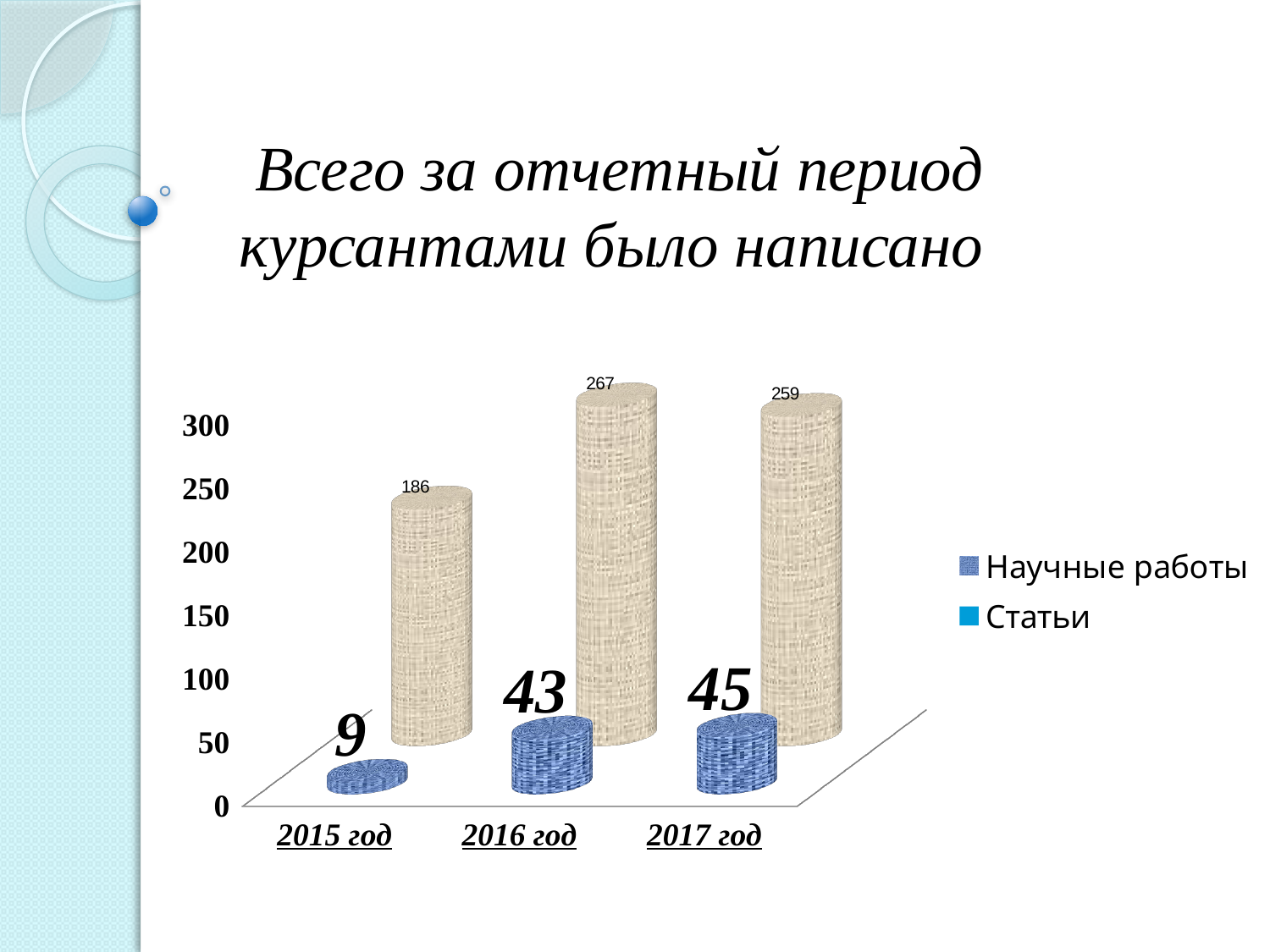
What kind of chart is shown on the slide? Bar chart What is the value for Статьи in 2017 год? 259 In which year is the value for Научные работы the lowest? 2015 год In which year is the value for Статьи the highest? 2016 год Which is larger: Статьи in 2016 год or Статьи in 2017 год? 2016 год What is the value for Научные работы in 2015 год? 9 What is the difference between the Научные работы values for 2016 год and 2015 год? 34 How many years are shown on the x axis? 3 What is the value for Статьи in 2016 год? 267 What is the value for Научные работы in 2017 год? 45 How many series does the legend list? 2 What is the difference between the Статьи values for 2016 год and 2015 год? 81